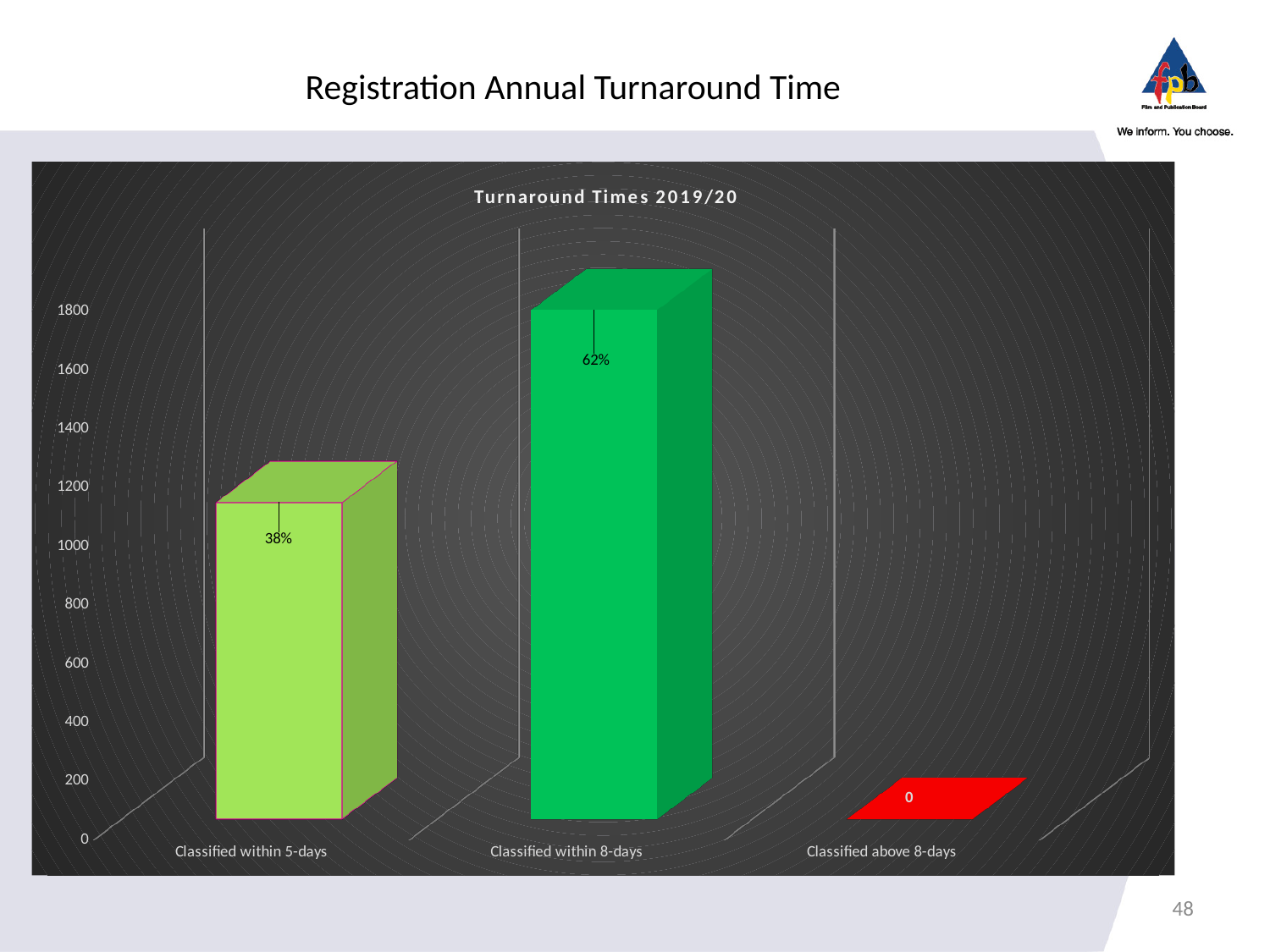
Is the value for Classified within 5-days greater or less than 800? greater What data label is shown on the bar for Classified within 8-days? 62% Which category has the tallest bar? Classified within 8-days Is the value for Classified within 8-days greater or less than 1400? greater What data label is shown for Classified above 8-days? 0 What data label is shown on the bar for Classified within 5-days? 38% Which category has the lowest value? Classified above 8-days How many categories are shown on the x axis? 3 What kind of chart is shown on the slide? Bar chart Is the value for Classified within 5-days greater or less than 1400? less What is the title of the chart? Turnaround Times 2019/20 Which bar is taller, Classified within 5-days or Classified within 8-days? Classified within 8-days